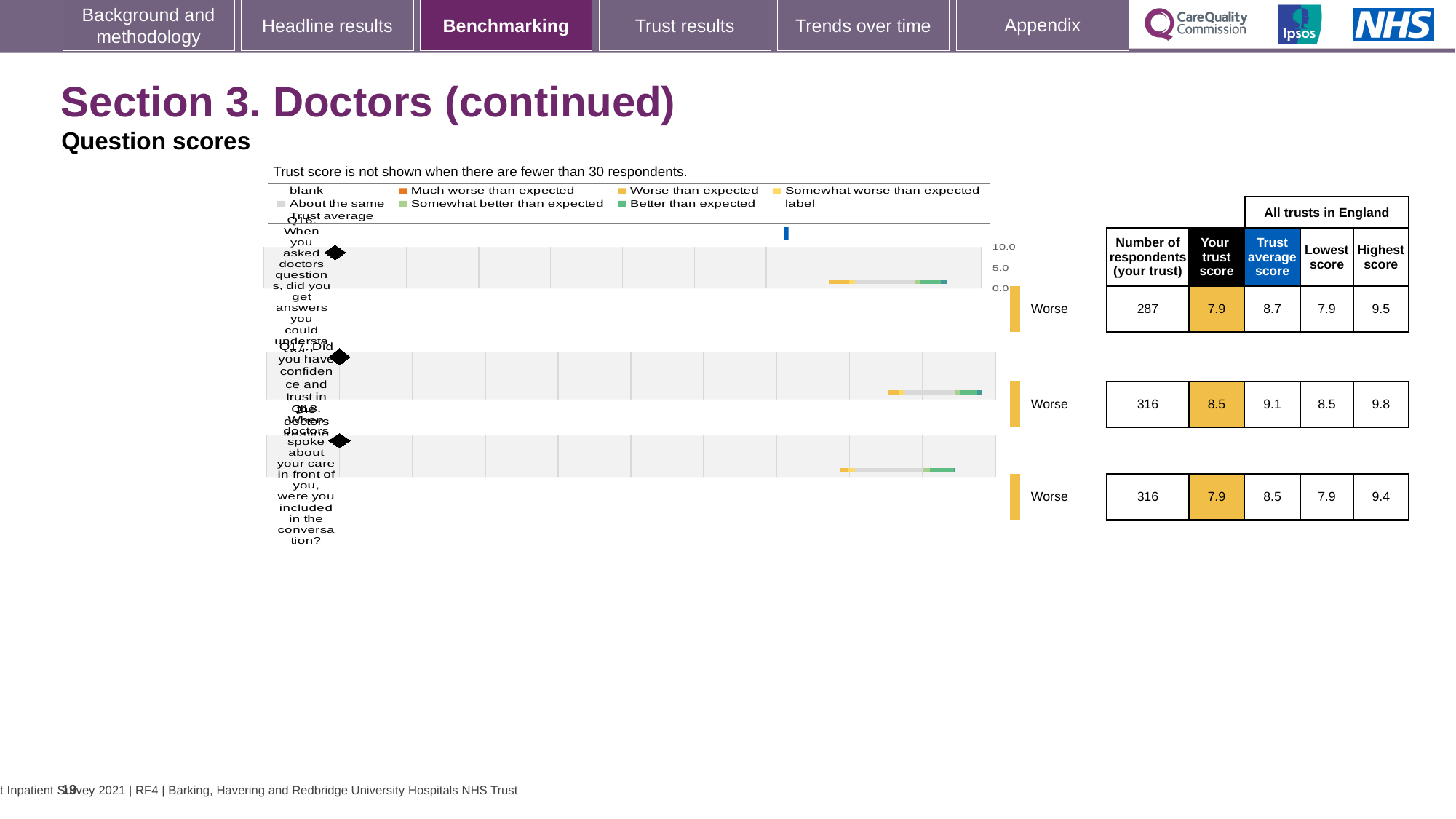
How many respondents from your trust answered Q16? 287 What is your trust score for Q17 (confidence and trust in the doctors)? 8.5 What is the trust average score for Q18 (included in the conversation when doctors spoke about your care)? 8.5 How many questions are plotted on this slide? 3 What kind of chart is used to show the question scores? Bar chart Which has the higher trust average score, Q17 or Q18? Q17 What is the difference between the trust average score and your trust score for Q16? 0.8 What benchmark category is shown for Q16? Worse What is the lowest score across all trusts in England for Q18? 7.9 According to the note above the charts, below how many respondents is the trust score not shown? 30 What is the highest score across all trusts in England for Q17? 9.8 Which question has the highest 'Your trust score' on this slide? Q17